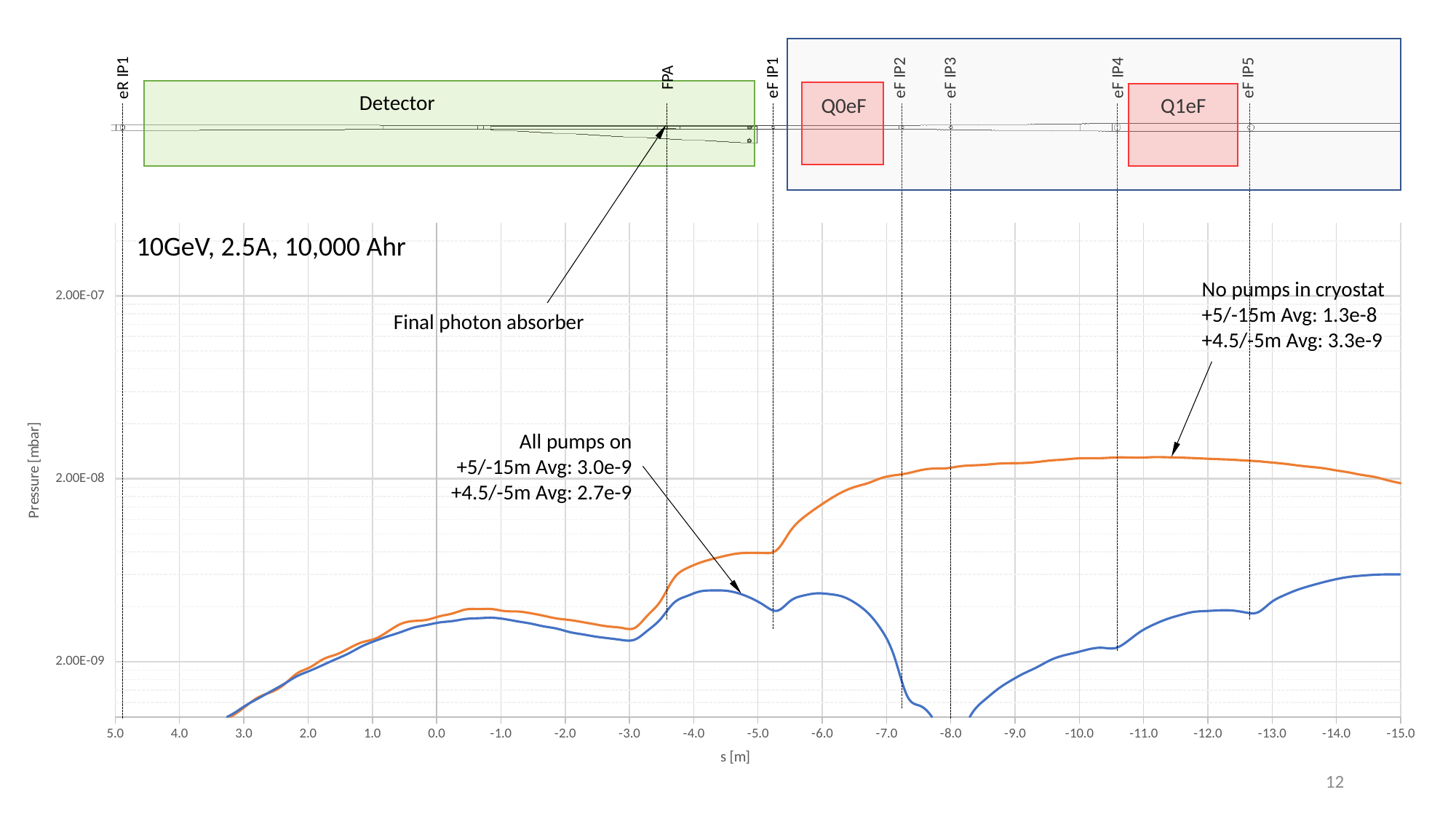
What is the +5/-15m average pressure for the 'All pumps on' case? 3.0e-9 At s = -8.0 m, is the pressure for the 'All pumps on' curve greater or less than 2.00E-09? less How many data series (curves) are plotted on the chart? 2 At s = -11.0 m, is the pressure for the 'No pumps in cryostat' curve greater or less than 2.00E-08? greater What is the +4.5/-5m average pressure for the 'All pumps on' case? 2.7e-9 What type of chart is shown on the slide? line chart What is the +5/-15m average pressure for the 'No pumps in cryostat' case? 1.3e-8 What is the label of the y-axis of the chart? Pressure [mbar] What operating condition is stated in the text at the top left of the chart? 10GeV, 2.5A, 10,000 Ahr Which case has the higher +5/-15m average pressure, 'All pumps on' or 'No pumps in cryostat'? No pumps in cryostat What is the +4.5/-5m average pressure for the 'No pumps in cryostat' case? 3.3e-9 What is the difference between the +5/-15m average pressures of the 'No pumps in cryostat' case and the 'All pumps on' case? 1.0e-8